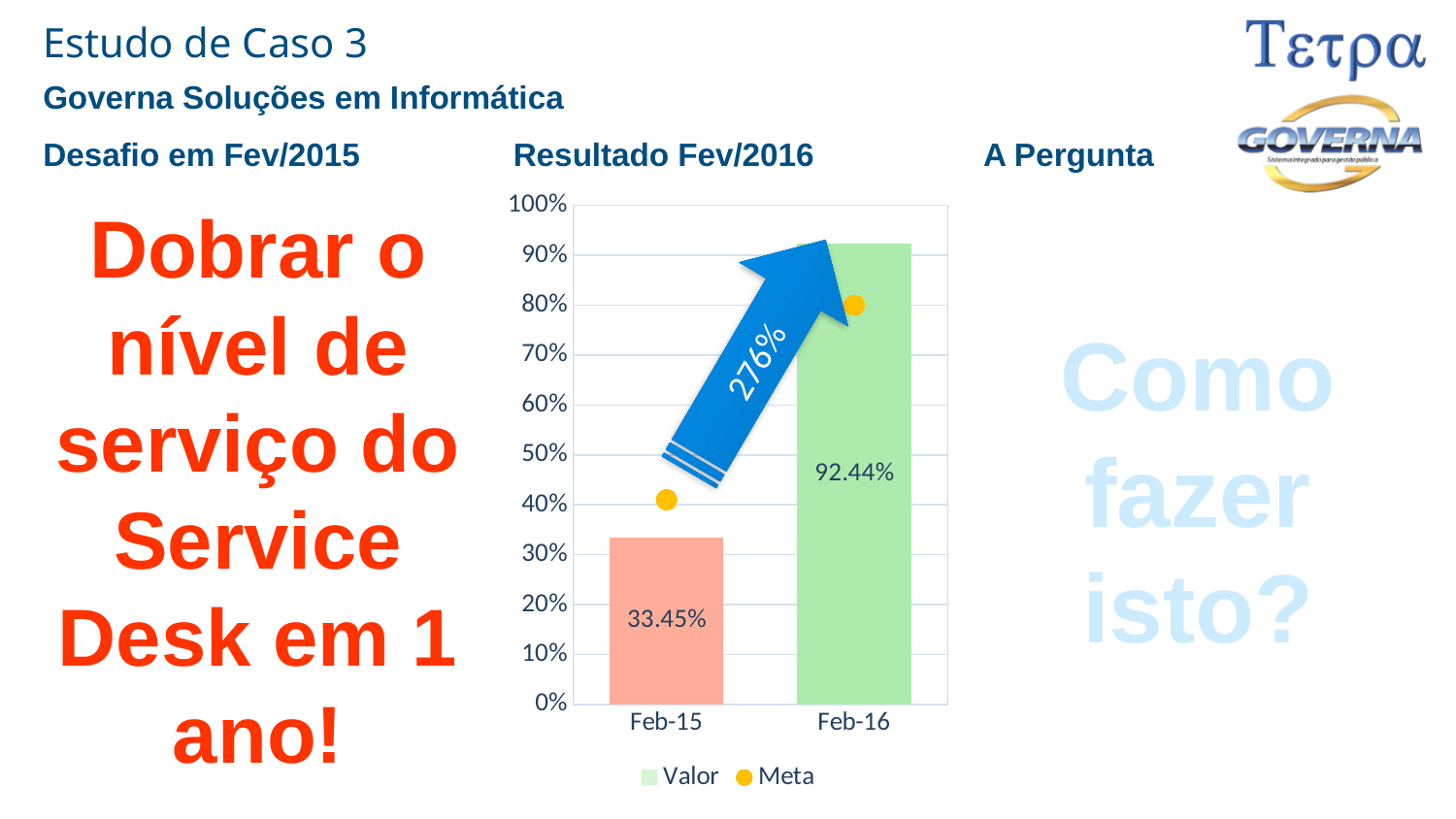
Is the Valor for Feb-16 larger or smaller than the Valor for Feb-15? larger What kind of chart is shown on the slide? bar chart Which category has the higher Valor bar? Feb-16 How many categories are shown on the x axis of the chart? 2 What is the Valor for Feb-16? 92.44% What is the Valor for Feb-15? 33.45% What percentage is written on the blue arrow in the chart? 276% Is the Meta value for Feb-16 greater or less than 70%? greater Which category has the lower Valor bar? Feb-15 What is the difference between the Valor for Feb-16 and the Valor for Feb-15? 58.99% Is the Meta value for Feb-15 greater or less than 50%? less How many series does the chart legend list? 2